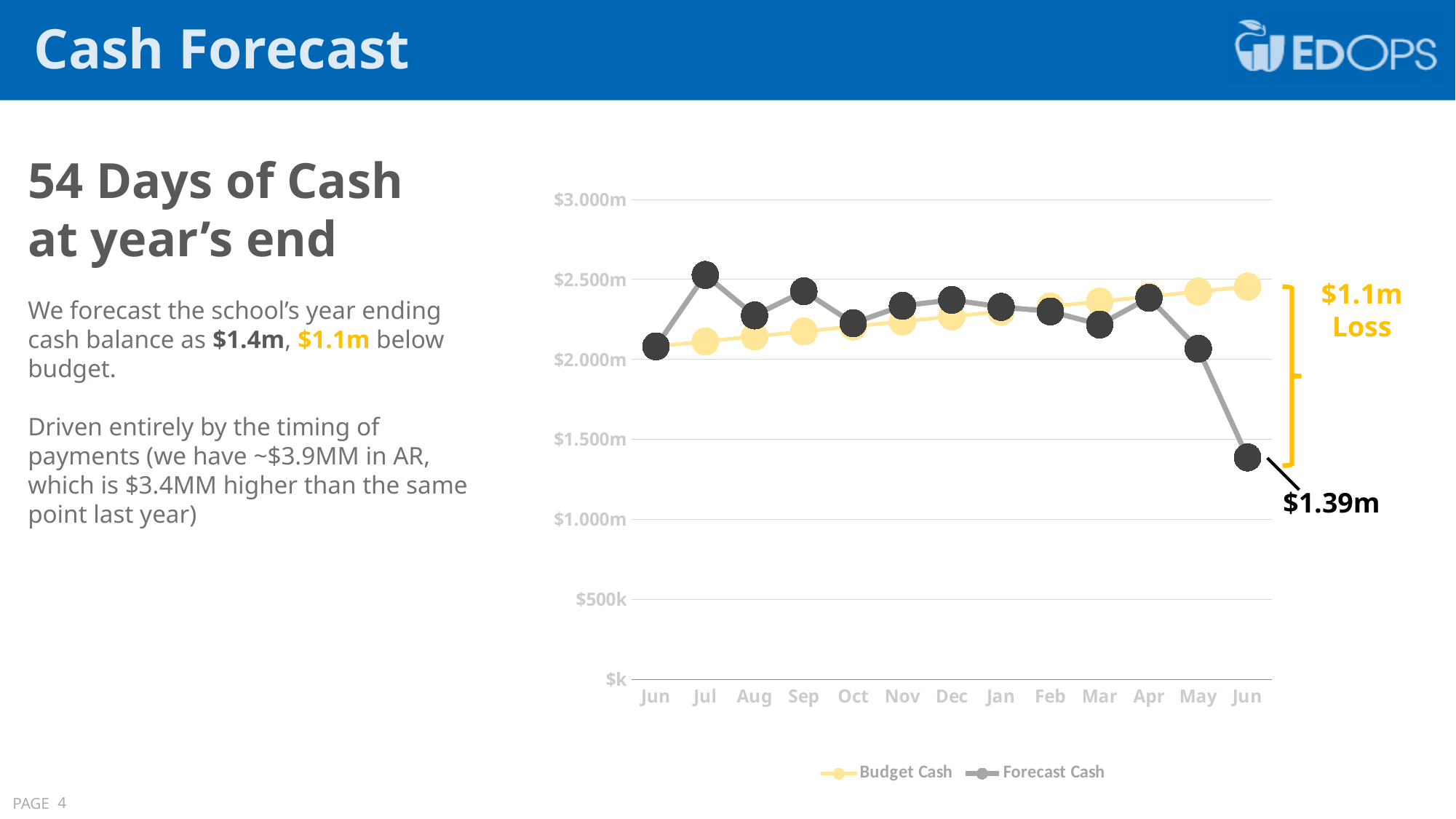
What loss amount is annotated next to the bracket on the right of the chart? $1.1m Loss How many months are plotted along the x axis of the chart? 13 In which month is Forecast Cash at its lowest? Jun (final) At the final Jun point, which series is higher, Budget Cash or Forecast Cash? Budget Cash Is the Forecast Cash value at the final Jun point greater or less than $1.500m? less Is the Budget Cash value at the final Jun point greater or less than $2.000m? greater In which month is Forecast Cash at its highest? Jul Does Budget Cash generally rise or fall from the first Jun to the final Jun? Rise What kind of chart is shown on the slide? Line chart How many series does the chart legend list? 2 In which month is Budget Cash at its highest? Jun (final) What is the Forecast Cash value labelled at the final Jun point? $1.39m